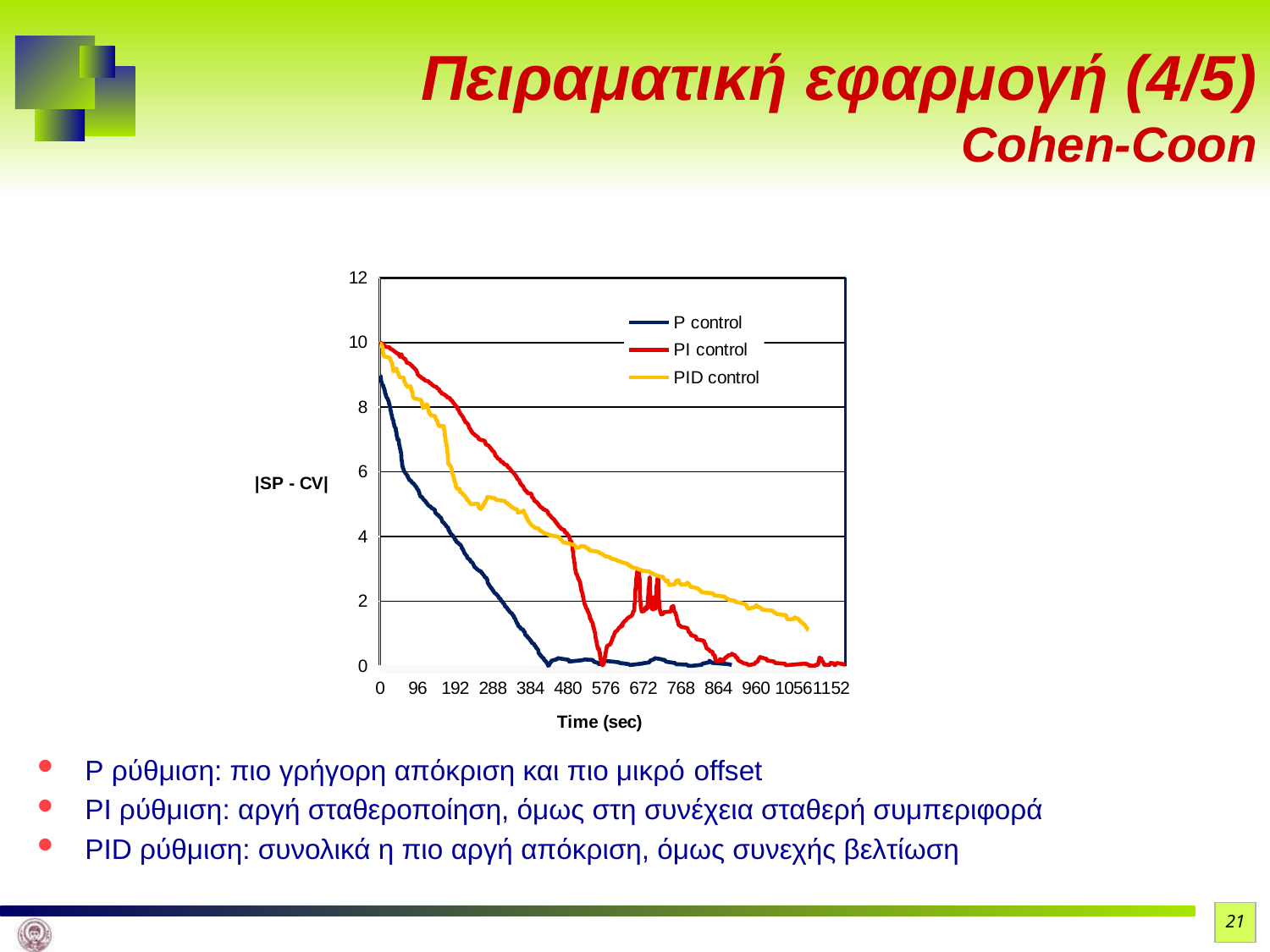
What are the three series named in the legend? P control, PI control, PID control How many series does the legend list? 3 What is the label of the vertical axis? |SP - CV| What kind of chart is shown on the slide? line chart Is the value of P control at time 192 greater or less than 6? less At time 288, which series has the larger value, P control or PI control? PI control Which series has the highest value at time 960? PID control Is the value of PID control at time 1056 greater or less than 2? less Which series is the first to reach a value of 0? P control At time 768, which series has the larger value, P control or PID control? PID control Is the value of P control at time 0 greater or less than 8? greater Do the values of the P control series rise or fall as time increases? fall